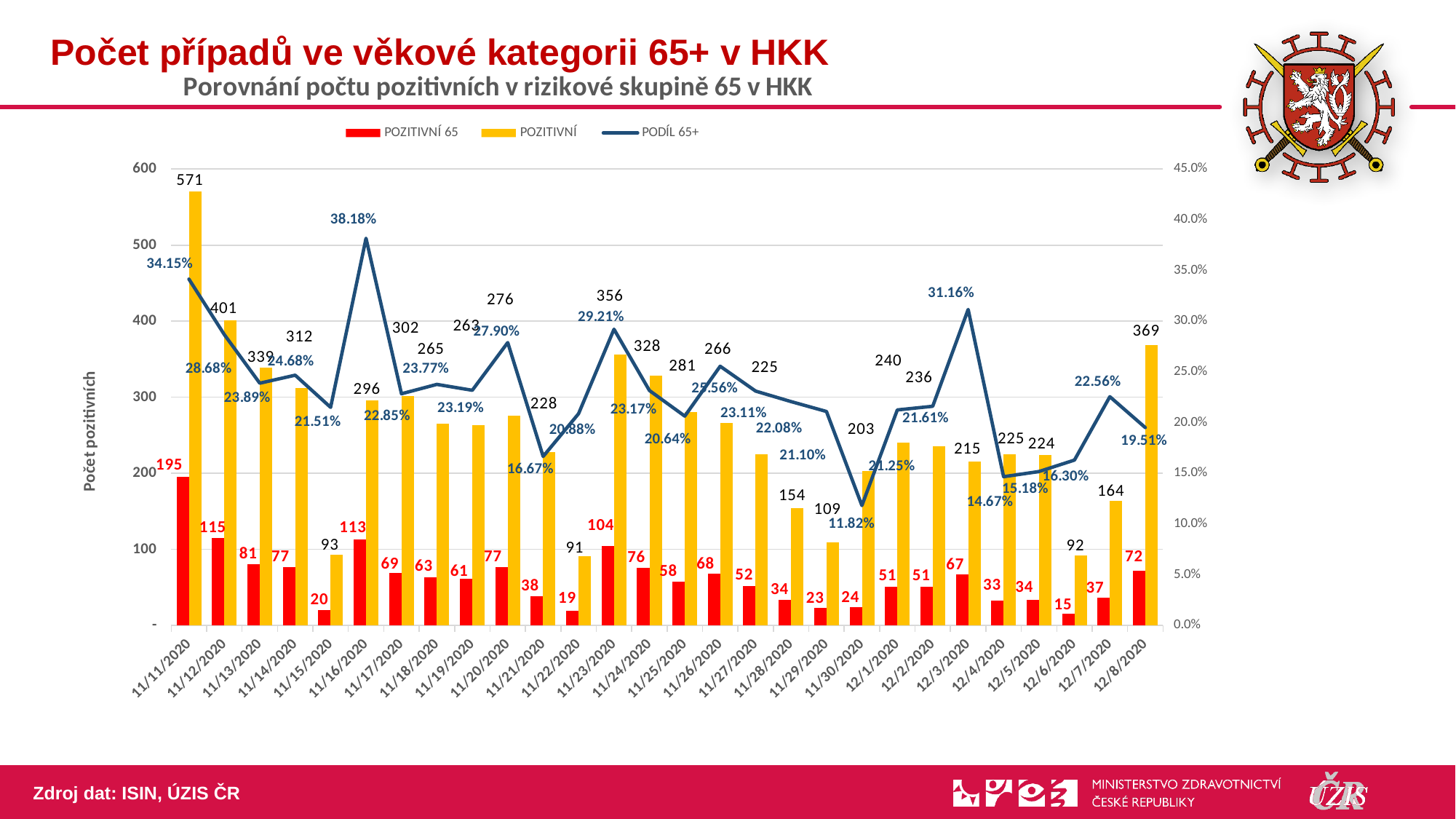
What kind of chart is this? Combined bar and line chart How many dates are shown on the x axis? 28 What is the title of the chart? Porovnání počtu pozitivních v rizikové skupině 65 v HKK What is the value of POZITIVNÍ 65 on 11/11/2020? 195 What is the PODÍL 65+ value on 11/16/2020? 38.18% On which date is the PODÍL 65+ value lowest? 11/30/2020 On which date is the POZITIVNÍ value highest? 11/11/2020 What is the value of POZITIVNÍ on 12/8/2020? 369 Which is larger: the POZITIVNÍ value on 12/8/2020 or on 11/23/2020? 12/8/2020 How many series does the legend list? 3 What is the difference between POZITIVNÍ and POZITIVNÍ 65 on 11/11/2020? 376 On which date is the POZITIVNÍ 65 value lowest? 12/6/2020